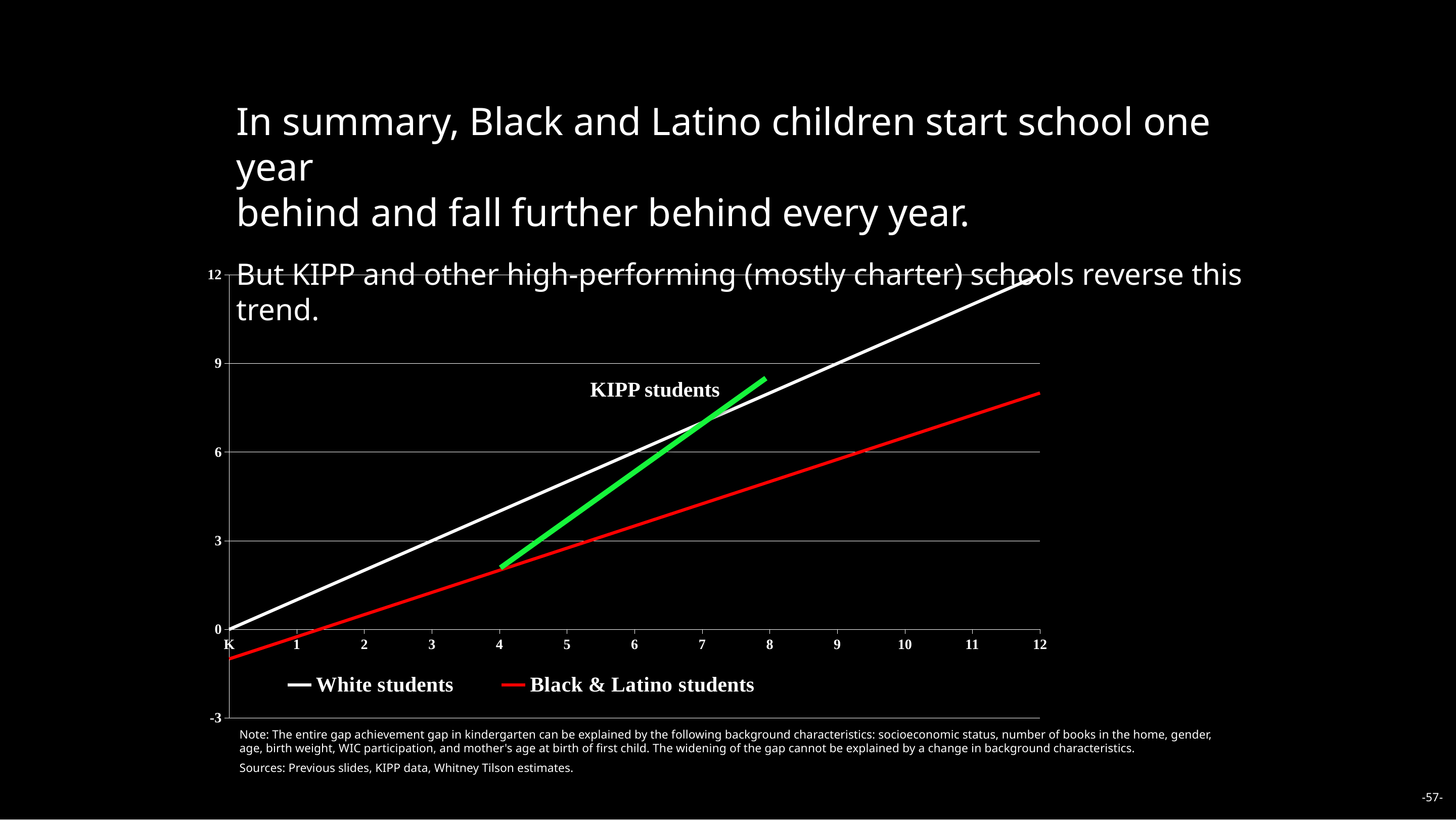
How many grade levels are marked along the x axis? 13 What kind of chart is shown on the slide? line chart Do the values for White students rise or fall from K to grade 12? rise Is the value for Black & Latino students at grade 12 greater or less than 6? greater What colour is the line labelled KIPP students? green What is the value for White students at grade 12? 12 Is the value for KIPP students at grade 8 greater or less than 6? greater Is the value for Black & Latino students at grade 12 greater or less than 9? less How many series does the legend list? 2 At grade 12, which series has the higher value, White students or Black & Latino students? White students What is the value for White students at K? 0